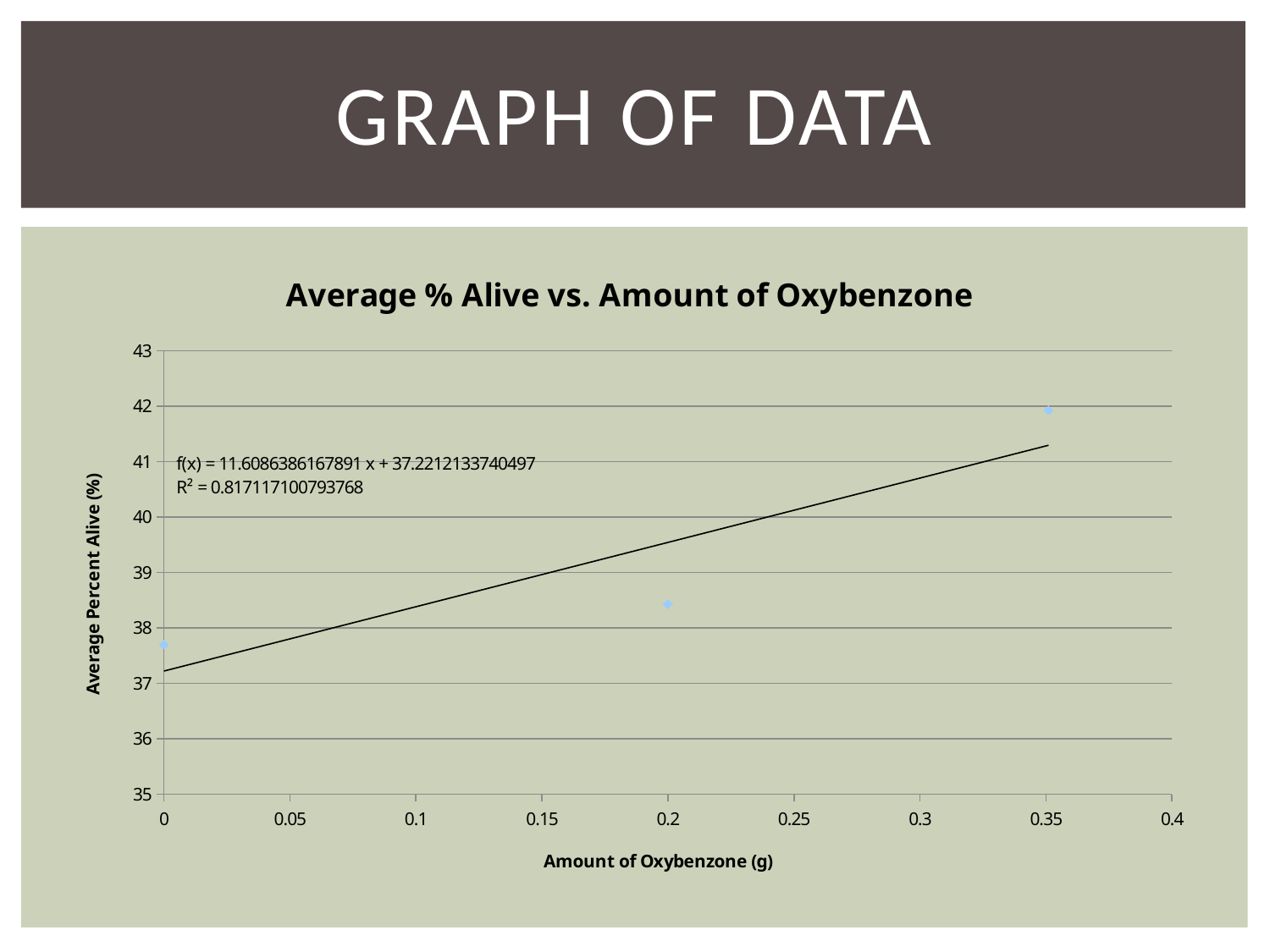
How many data points are plotted on the chart? 3 What kind of chart is shown on the slide? scatter chart Which amount of oxybenzone has the lowest average percent alive? 0 What is the label of the x axis? Amount of Oxybenzone (g) Which amount of oxybenzone has the highest average percent alive? 0.35 Is the value for 0.2 g of oxybenzone greater or less than 39? less What is the R² value shown for the trendline? 0.817117100793768 Is the value for 0 g of oxybenzone greater or less than 38? less What is the title of the chart? Average % Alive vs. Amount of Oxybenzone Which has a higher average percent alive, 0.2 g or 0.35 g of oxybenzone? 0.35 g Is the value for 0.35 g of oxybenzone greater or less than 41? greater Do the plotted values rise or fall as the amount of oxybenzone increases? rise